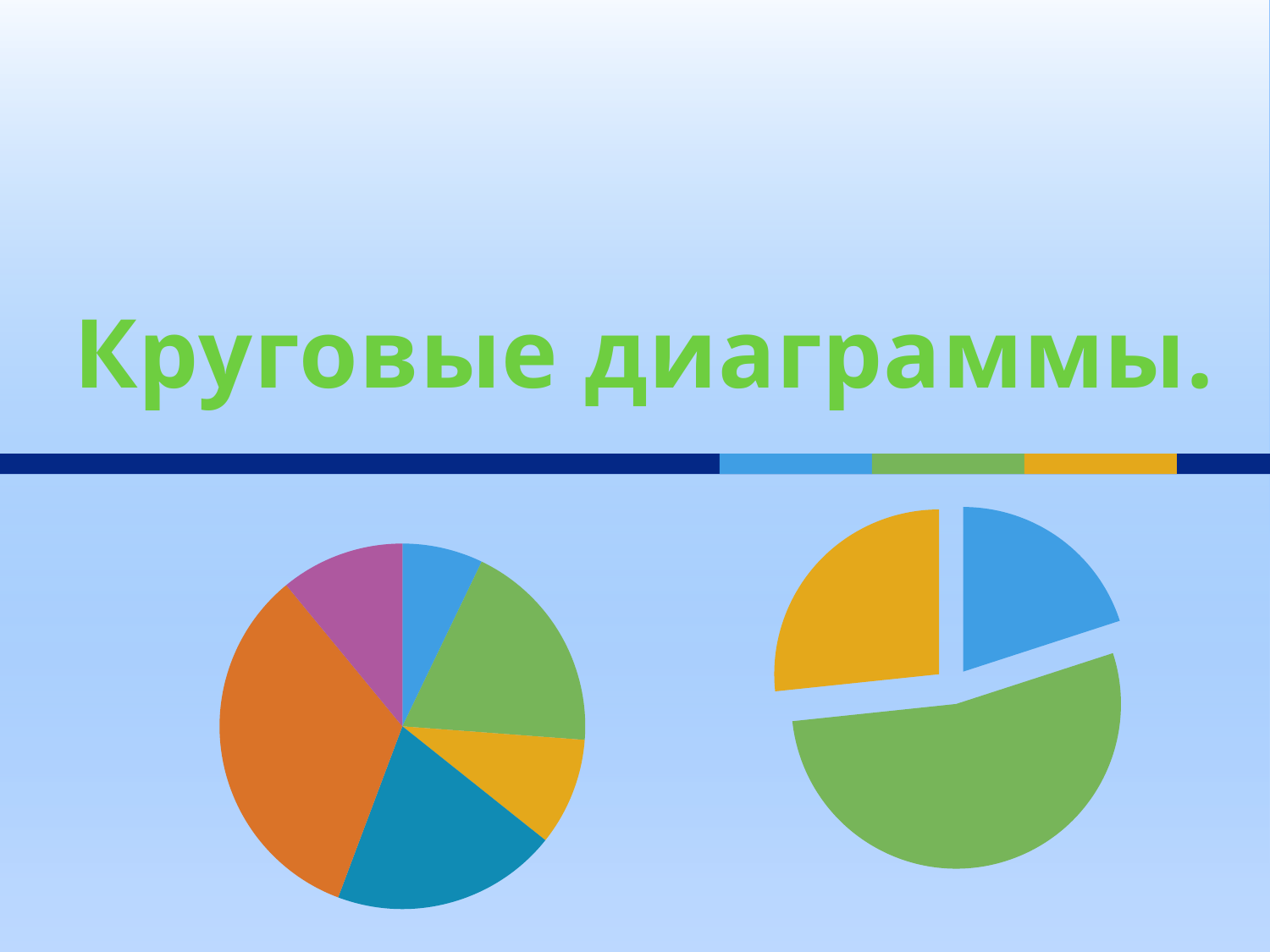
How many slices does the pie chart on the left have? 6 In the pie chart on the left, which slice is larger, the dark blue one or the yellow one? dark blue What kind of chart is the chart on the left of the slide? pie chart How many slices does the pie chart on the right have? 3 What is the title of the slide? Круговые диаграммы. What kind of chart is the chart on the right of the slide? pie chart In the pie chart on the left, which slice is larger, the orange one or the light blue one? orange In the pie chart on the right, which colour slice is the largest? green Are the slices of the pie chart on the right separated from each other (exploded)? yes In the pie chart on the left, which colour slice is the largest? orange In the pie chart on the right, which slice is larger, the green one or the blue one? green